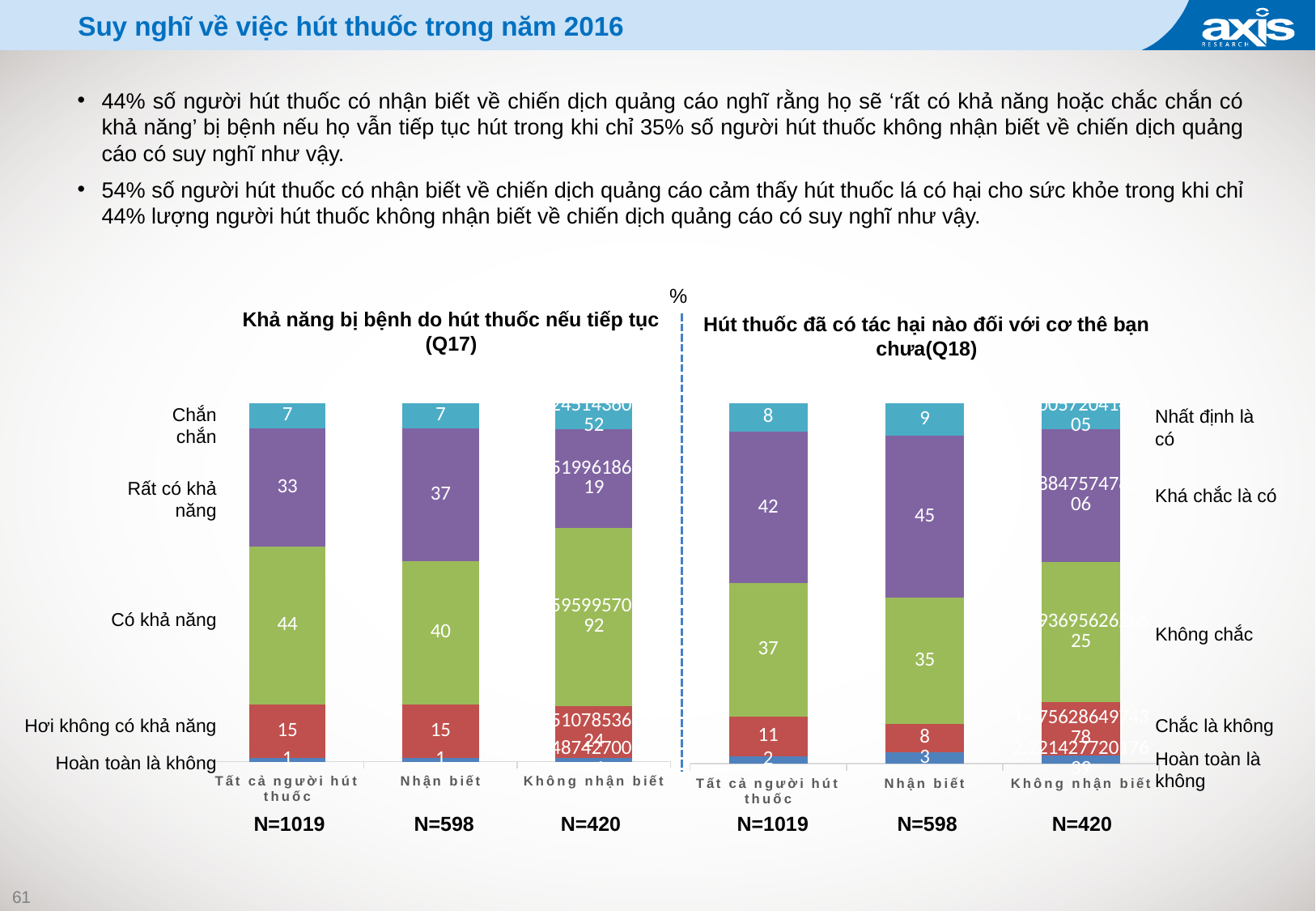
In the left chart (Q17), which segment is the largest in the 'Nhận biết' bar? Có khả năng In the right chart (Q18), which segment is the smallest in the 'Tất cả người hút thuốc' bar? Hoàn toàn là không In the right chart (Q18), what is the difference between 'Không chắc' for 'Tất cả người hút thuốc' and for 'Nhận biết'? 2 What type of chart is used for Q18 on the right? Stacked bar chart In the left chart (Q17), what is the value of 'Có khả năng' for 'Tất cả người hút thuốc'? 44 In the right chart (Q18), which is larger for 'Nhận biết': 'Khá chắc là có' or 'Không chắc'? Khá chắc là có How many bars (categories) does the left chart (Q17) show? 3 In the left chart (Q17), what is the value of 'Rất có khả năng' for 'Nhận biết'? 37 In the left chart (Q17), what is the difference between 'Có khả năng' for 'Tất cả người hút thuốc' and for 'Nhận biết'? 4 In the right chart (Q18), what is the value of 'Khá chắc là có' for 'Nhận biết'? 45 In the right chart (Q18), what is the total of the 'Nhận biết' stacked bar? 100 In the right chart (Q18), what is the value of 'Chắc là không' for 'Tất cả người hút thuốc'? 11